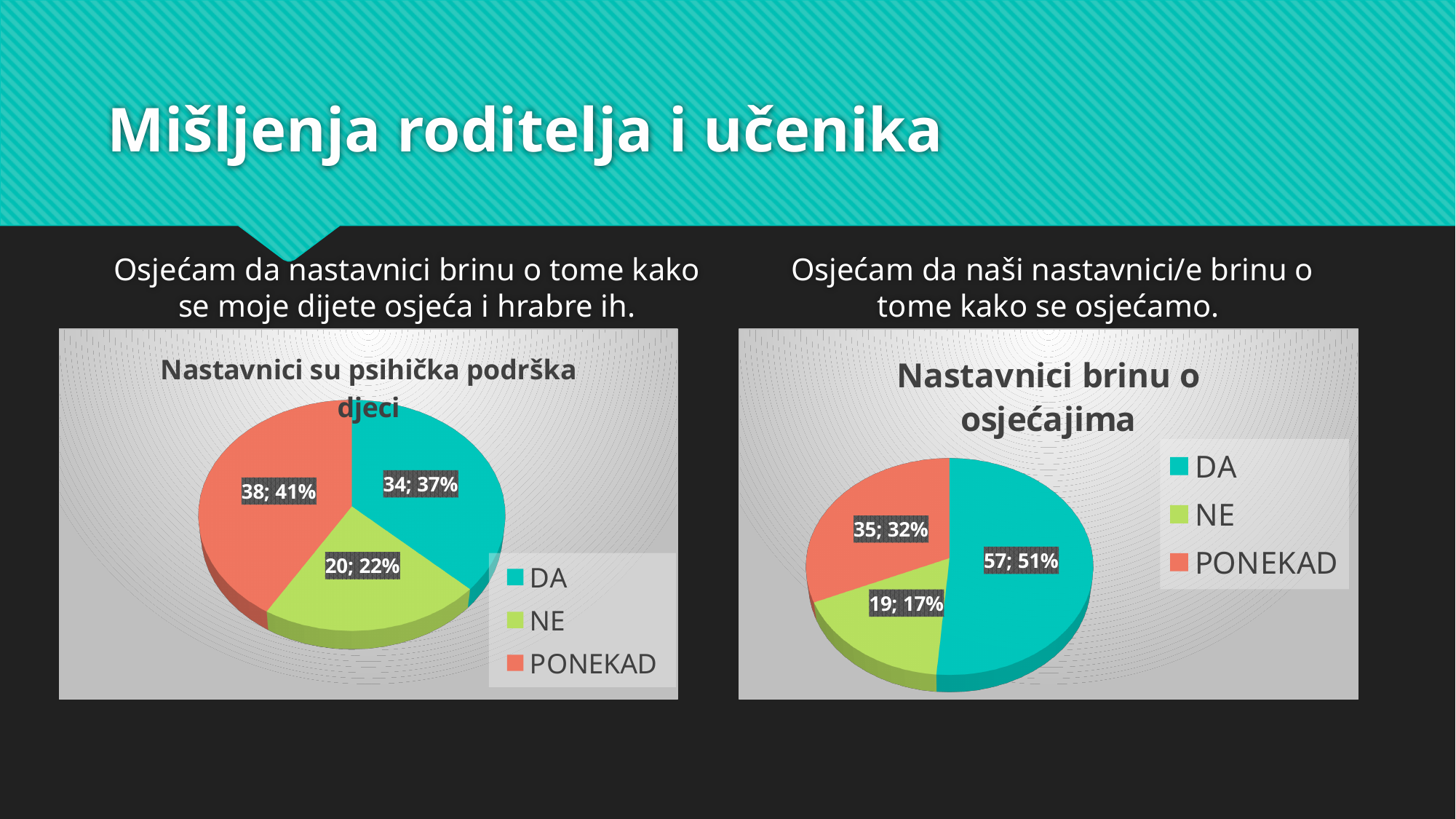
In the right chart 'Nastavnici brinu o osjećajima', is the count for PONEKAD larger or smaller than the count for NE? larger In the right chart 'Nastavnici brinu o osjećajima', which category has the largest slice? DA How many categories does the legend of the right chart 'Nastavnici brinu o osjećajima' list? 3 In the left chart 'Nastavnici su psihička podrška djeci', what is the count for PONEKAD? 38 In the right chart 'Nastavnici brinu o osjećajima', what percentage share does NE have? 17% What type of chart is used in the left chart 'Nastavnici su psihička podrška djeci'? pie chart In the left chart 'Nastavnici su psihička podrška djeci', what is the difference between the counts for PONEKAD and NE? 18 In the right chart 'Nastavnici brinu o osjećajima', what is the total of all three counts? 111 In the left chart 'Nastavnici su psihička podrška djeci', which category has the largest slice? PONEKAD In the left chart 'Nastavnici su psihička podrška djeci', what percentage share does DA have? 37% In the right chart 'Nastavnici brinu o osjećajima', what is the count for DA? 57 In the left chart 'Nastavnici su psihička podrška djeci', which category has the smallest slice? NE